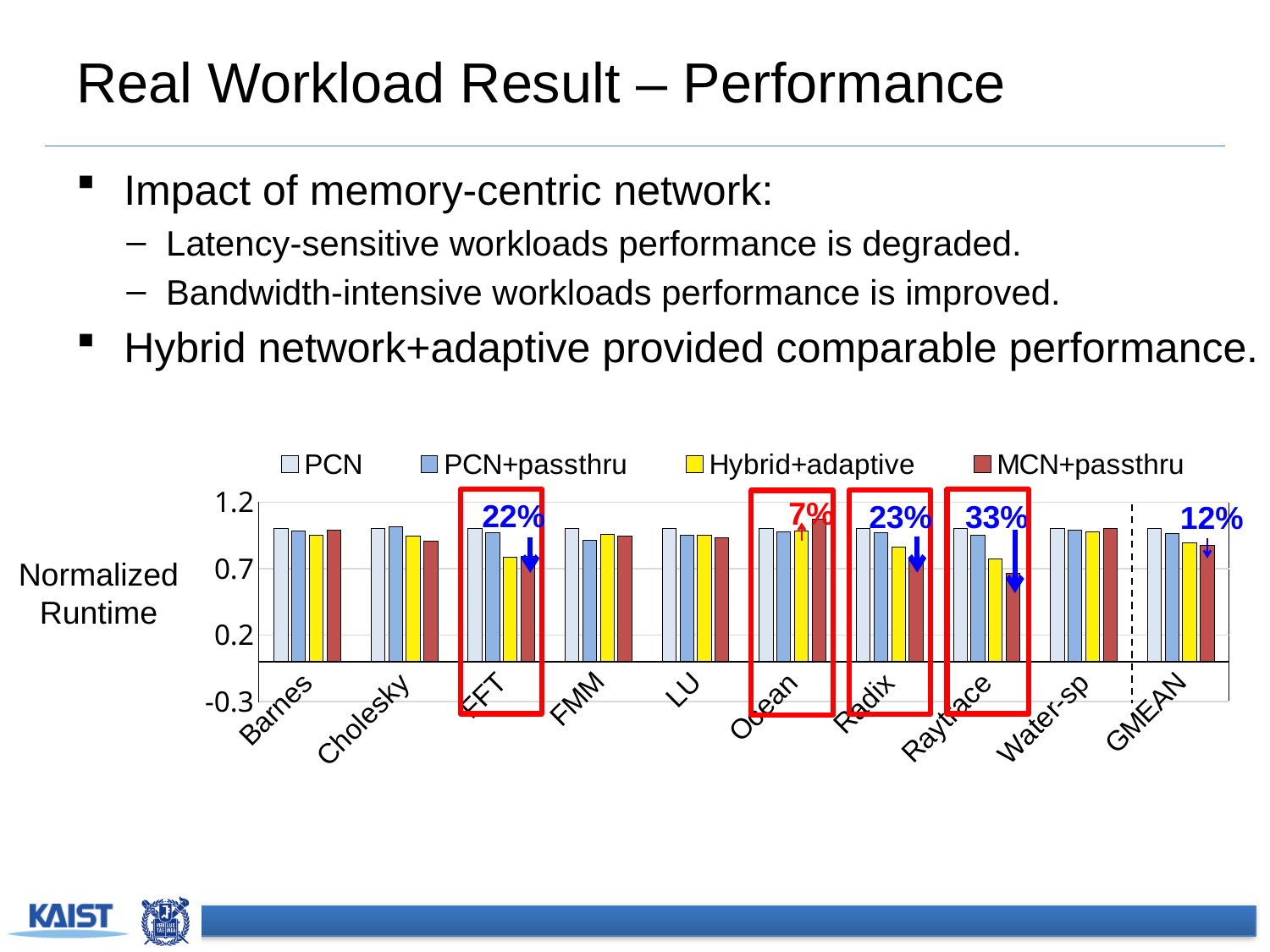
What percentage is annotated above the GMEAN group in the chart? 12% What percentage is annotated above the Ocean group in the chart? 7% What percentage is annotated above the FFT group in the chart? 22% How many workload categories are shown along the x axis of the chart (including GMEAN)? 10 What percentage is annotated above the Raytrace group in the chart? 33% Is the value for PCN in the Barnes group greater or less than 0.7? greater Which series has the lowest bar in the Raytrace group? MCN+passthru Which series has the highest bar in the Ocean group? MCN+passthru What is the label on the y axis of the chart? Normalized Runtime In the Raytrace group, which is larger: the PCN bar or the Hybrid+adaptive bar? PCN What kind of chart is shown on the slide? bar chart How many series does the chart legend list? 4